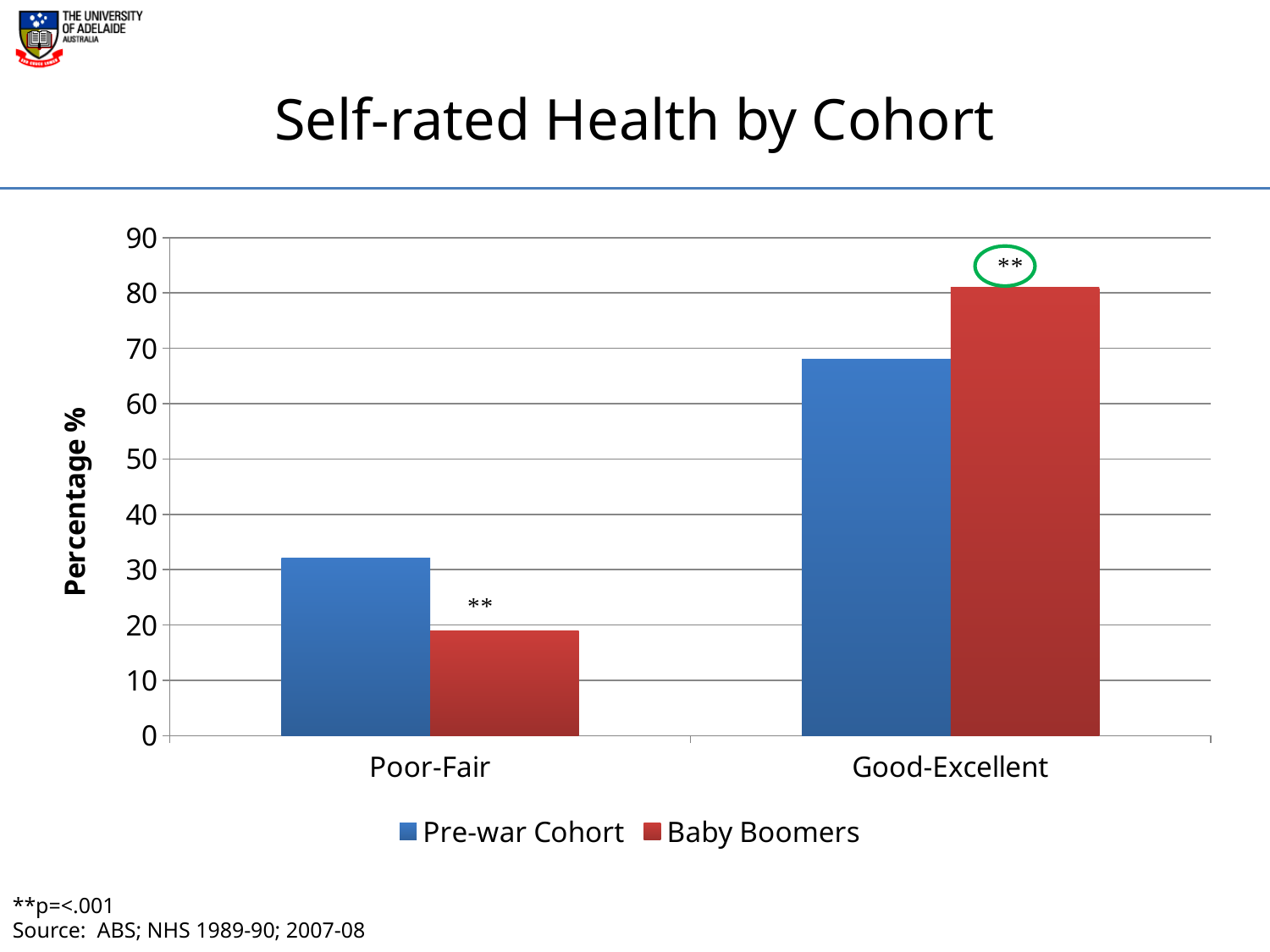
Is the Pre-war Cohort value for Good-Excellent greater or less than 70? less How many series does the legend list? 2 Which series has the higher value for Good-Excellent, Pre-war Cohort or Baby Boomers? Baby Boomers What kind of chart is shown on the slide? bar chart Which series has the higher value for Poor-Fair, Pre-war Cohort or Baby Boomers? Pre-war Cohort Is the Pre-war Cohort value for Poor-Fair greater or less than 30? greater Which bar is the tallest in the chart? Baby Boomers, Good-Excellent How many categories are shown on the x axis? 2 Which bar is the shortest in the chart? Baby Boomers, Poor-Fair What is the label of the y axis? Percentage %